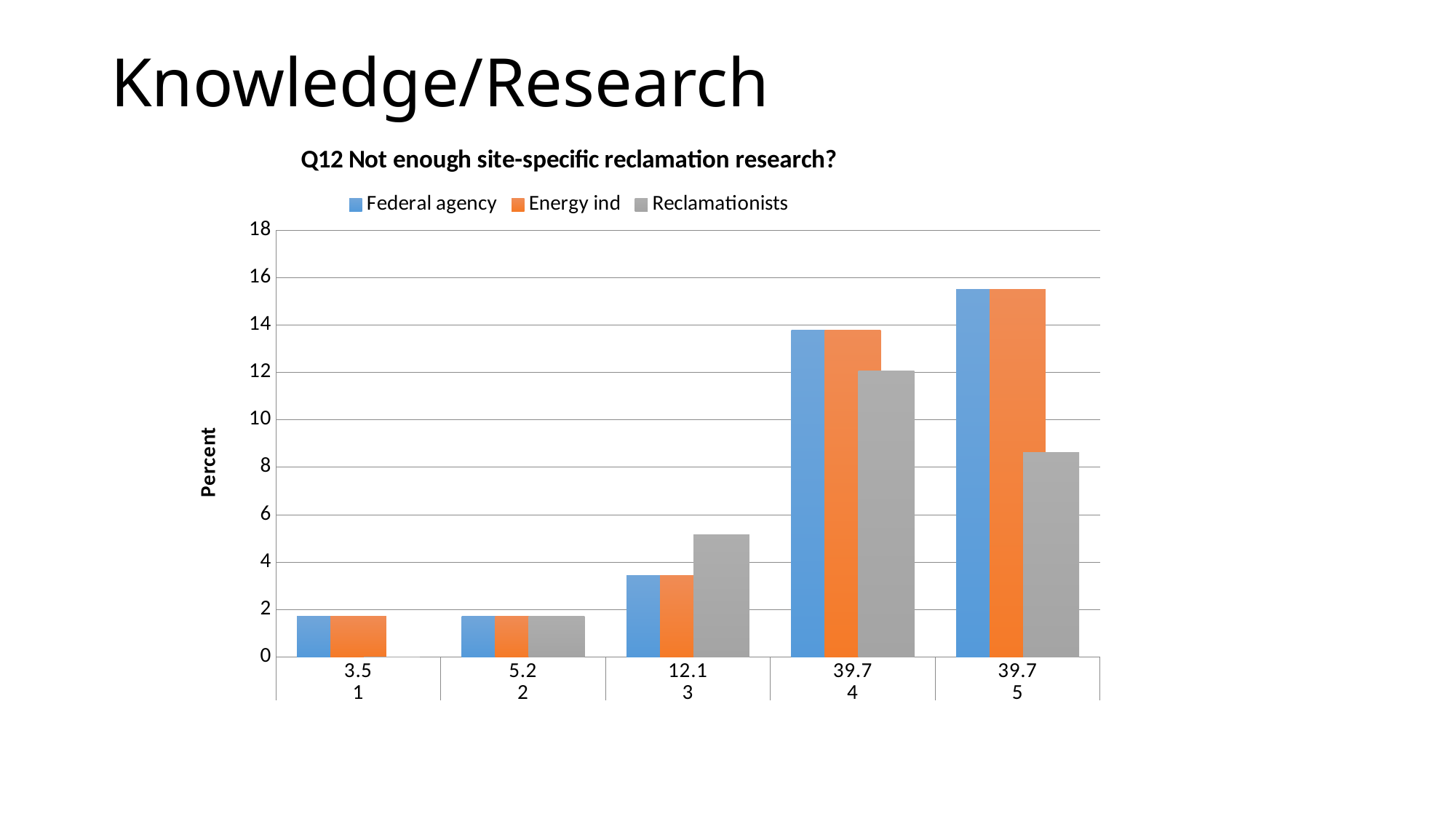
How many categories are shown along the x axis? 5 In category 5, which is larger: the Energy ind bar or the Reclamationists bar? Energy ind For the Federal agency series, which category has the highest bar? 5 Is the Federal agency value for category 5 greater or less than 14? greater What type of chart is shown on the slide? bar chart How many series does the legend list? 3 What is the title of the vertical axis? Percent Do the Federal agency values rise or fall from category 1 to category 5? rise For the Reclamationists series, which category has the highest bar? 4 Is the Reclamationists value for category 5 greater or less than 10? less Is the Reclamationists value for category 4 greater or less than 10? greater In category 3, which is larger: the Reclamationists bar or the Federal agency bar? Reclamationists